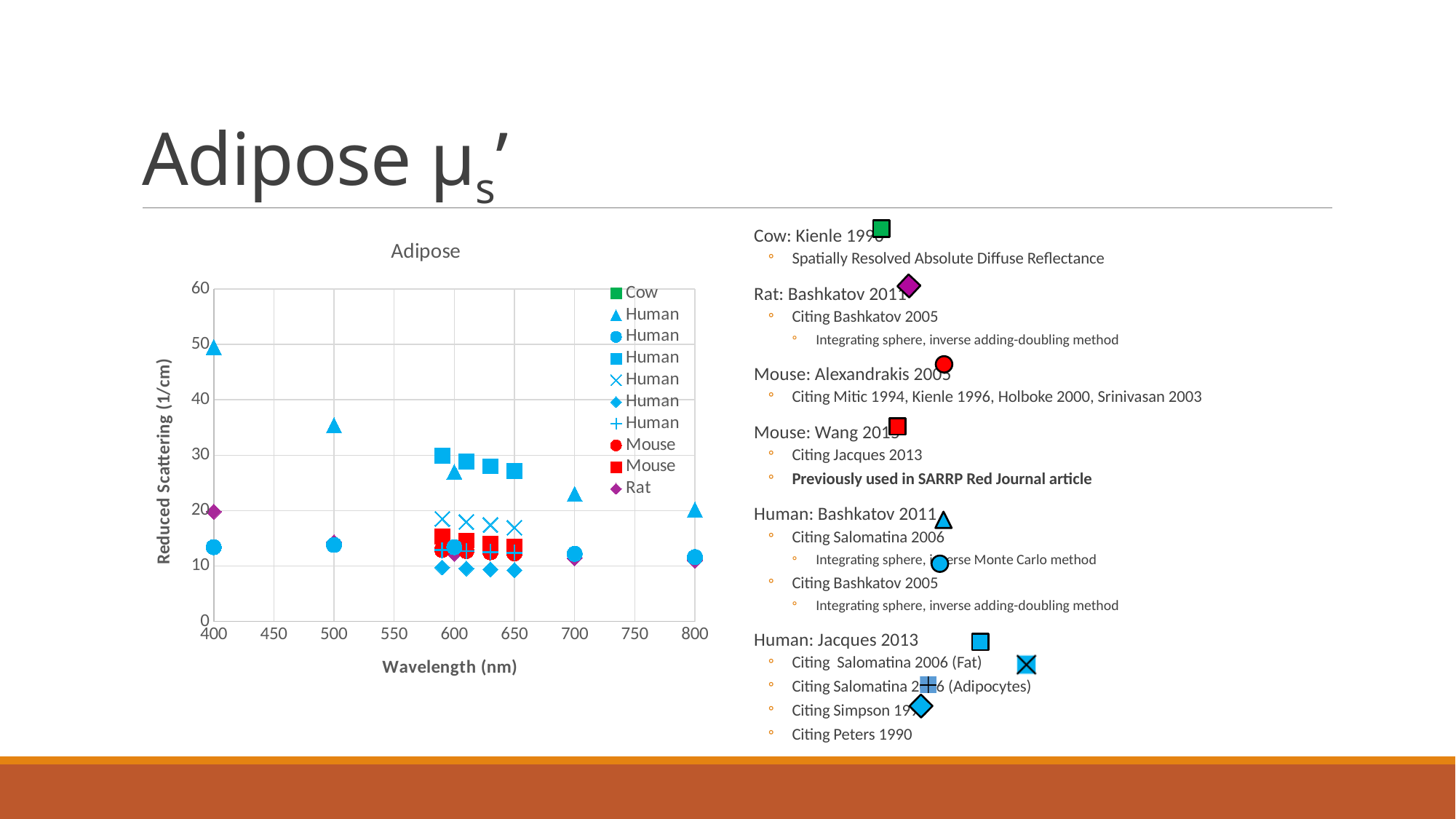
Is the value of the Human circle series at 400 nm greater or less than 10? greater Is the value of the Human triangle series at 400 nm greater or less than 40? greater Is the value of the Human square series at 650 nm greater or less than 30? less What kind of chart is shown on the slide? scatter chart What is the title of the chart? Adipose How many series does the chart legend list? 10 Does the Human triangle series rise or fall as wavelength increases from 400 nm to 800 nm? fall What is the label of the vertical axis? Reduced Scattering (1/cm) How many legend entries are labelled "Human"? 6 How many legend entries are labelled "Mouse"? 2 At which wavelength does the highest plotted value on the chart occur? 400